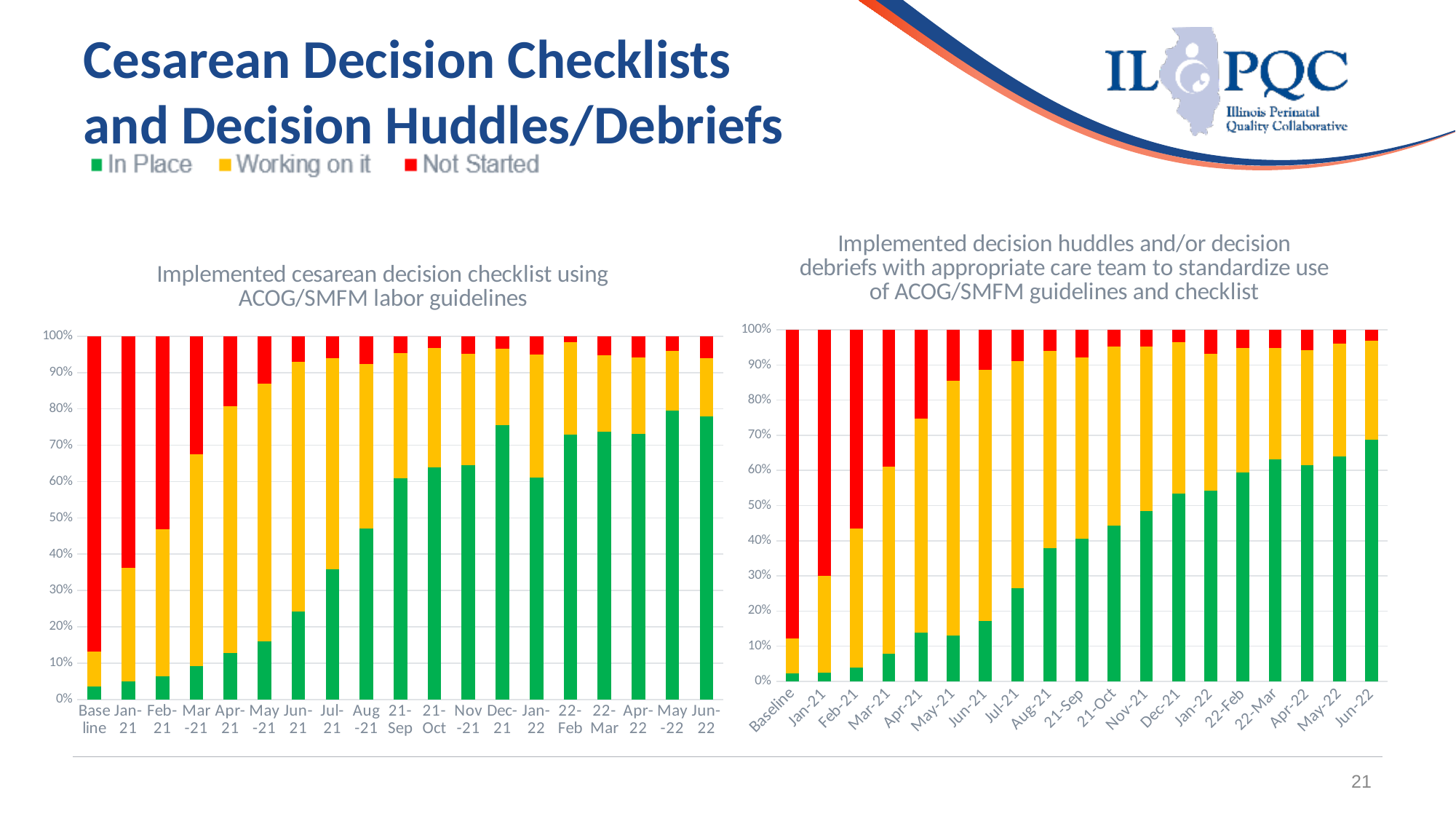
In the left chart, 'Implemented cesarean decision checklist', does the 'In Place' share generally rise or fall from Baseline to Jun-22? Rise In the right chart, 'Implemented decision huddles and/or decision debriefs', is the 'In Place' value for Baseline greater or less than 10%? less Which colour represents 'Not Started' in the charts on this slide? Red How many series does the legend list for the charts on this slide? 3 What kind of chart is the left chart, 'Implemented cesarean decision checklist using ACOG/SMFM labor guidelines'? Stacked bar chart How many time-period categories are plotted on the left chart, 'Implemented cesarean decision checklist using ACOG/SMFM labor guidelines'? 19 What are the three series named in the legend? In Place, Working on it, Not Started In the right chart, 'Implemented decision huddles and/or decision debriefs', is the 'In Place' value for Jun-22 greater or less than 60%? greater In the right chart, 'Implemented decision huddles and/or decision debriefs', which period has the highest 'In Place' share? Jun-22 How many time-period categories are plotted on the right chart, 'Implemented decision huddles and/or decision debriefs'? 19 In the left chart, 'Implemented cesarean decision checklist', is the 'In Place' value for May-22 greater or less than 70%? greater